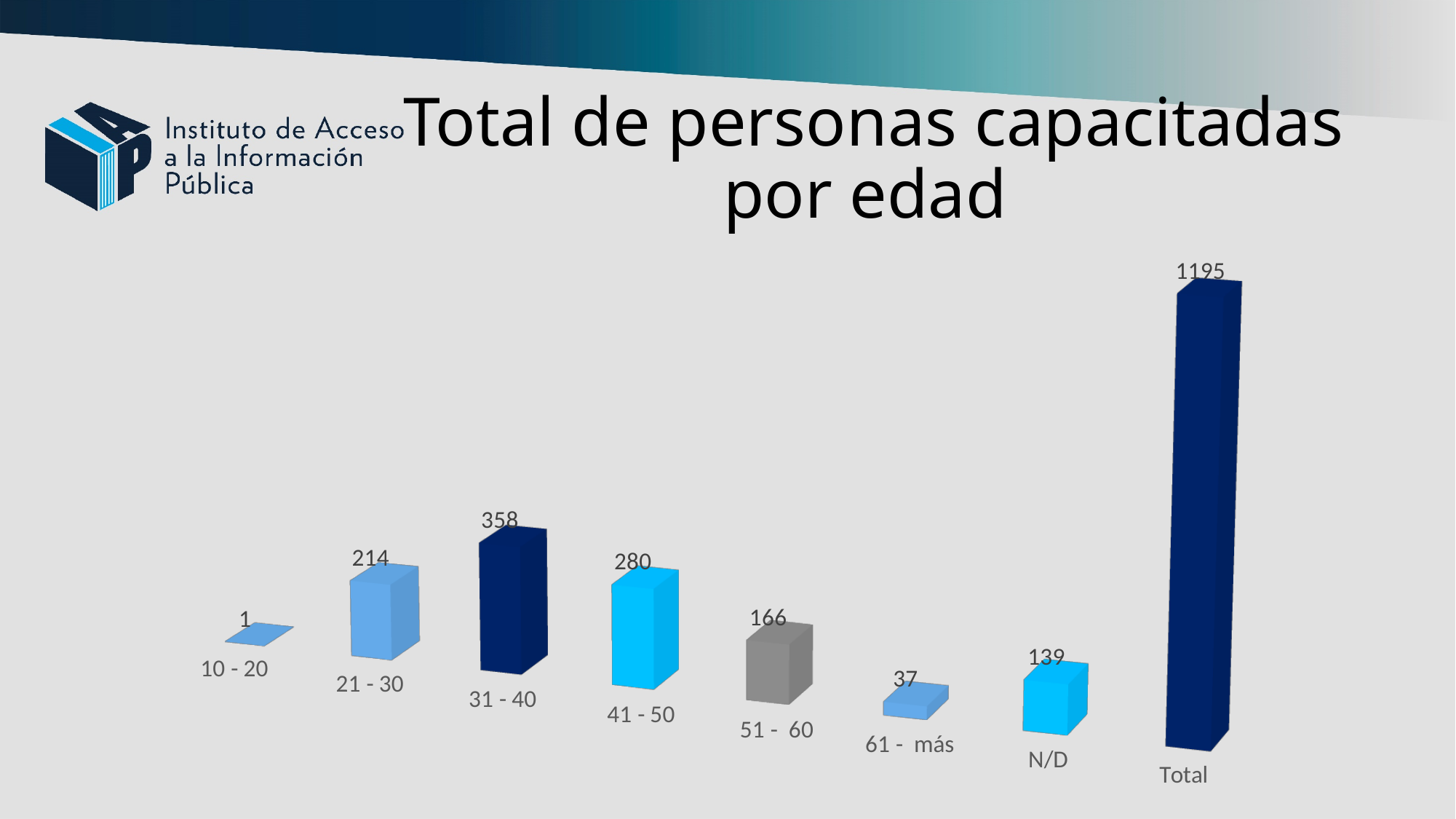
Which is larger, the value for 51 - 60 or the value for N/D? 51 - 60 What is the value for the N/D category? 139 What is the title of the chart? Total de personas capacitadas por edad What is the value for the 10 - 20 age group? 1 What is the value for the 31 - 40 age group? 358 How many categories are shown on the x axis, including Total? 8 What is the difference between the values for 31 - 40 and 41 - 50? 78 What is the value shown for the Total bar? 1195 What is the difference between the values for 21 - 30 and 51 - 60? 48 What kind of chart is shown on the slide? Bar chart Which age group (excluding Total) has the highest value? 31 - 40 Which category has the lowest value? 10 - 20